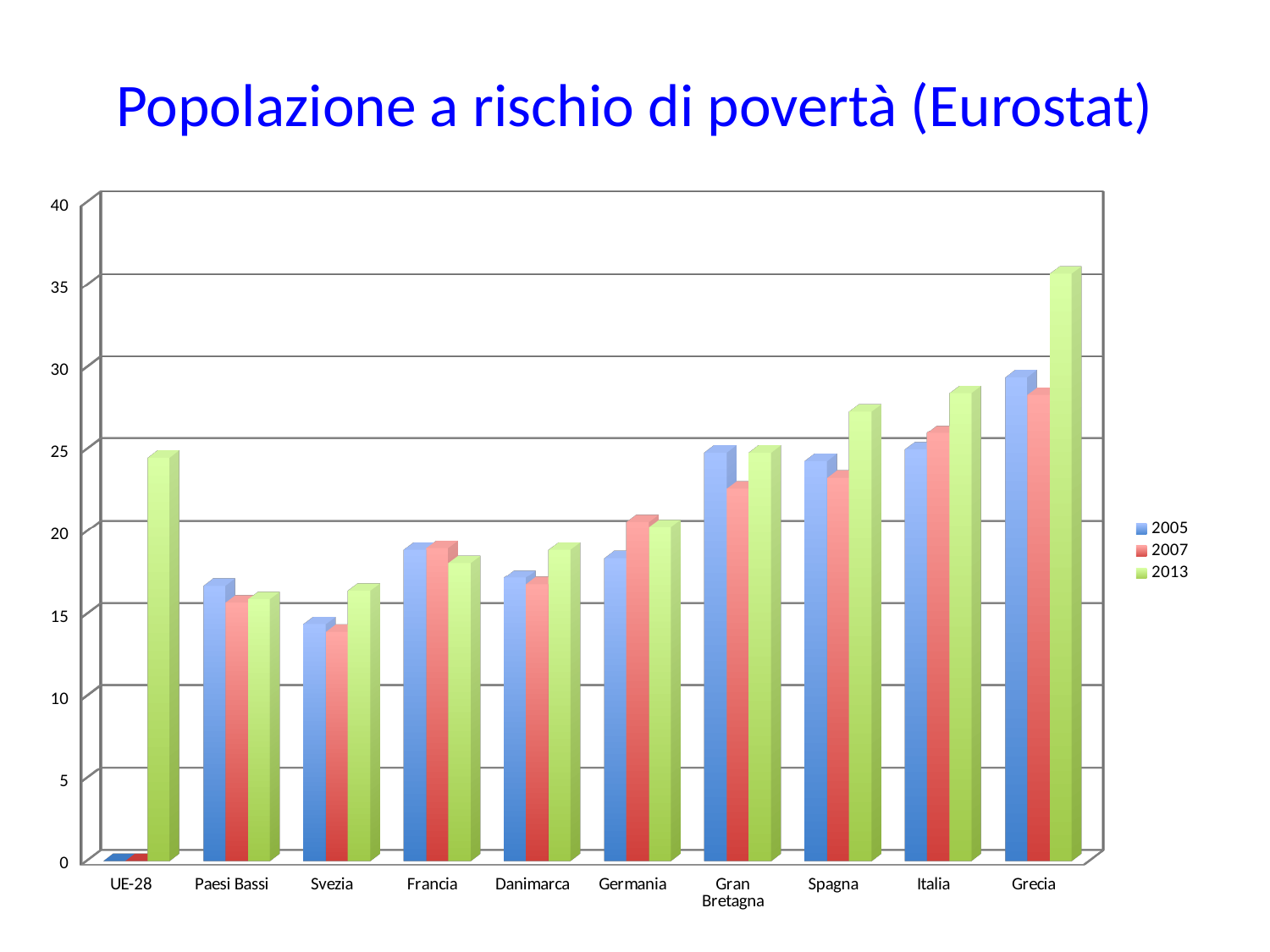
Is the 2013 value for Grecia greater or less than 30? greater How many countries/categories are shown on the x axis? 10 How many series does the legend list? 3 Which category has the highest 2005 value? Grecia For Grecia, which is larger: the 2005 value or the 2013 value? 2013 What kind of chart is shown on the slide? bar chart Which category has the highest 2013 value? Grecia Is the 2013 value for Danimarca greater or less than 20? less What is the title of the chart? Popolazione a rischio di povertà (Eurostat) For Gran Bretagna, which is larger: the 2005 value or the 2007 value? 2005 Is the 2005 value for Svezia greater or less than 15? less